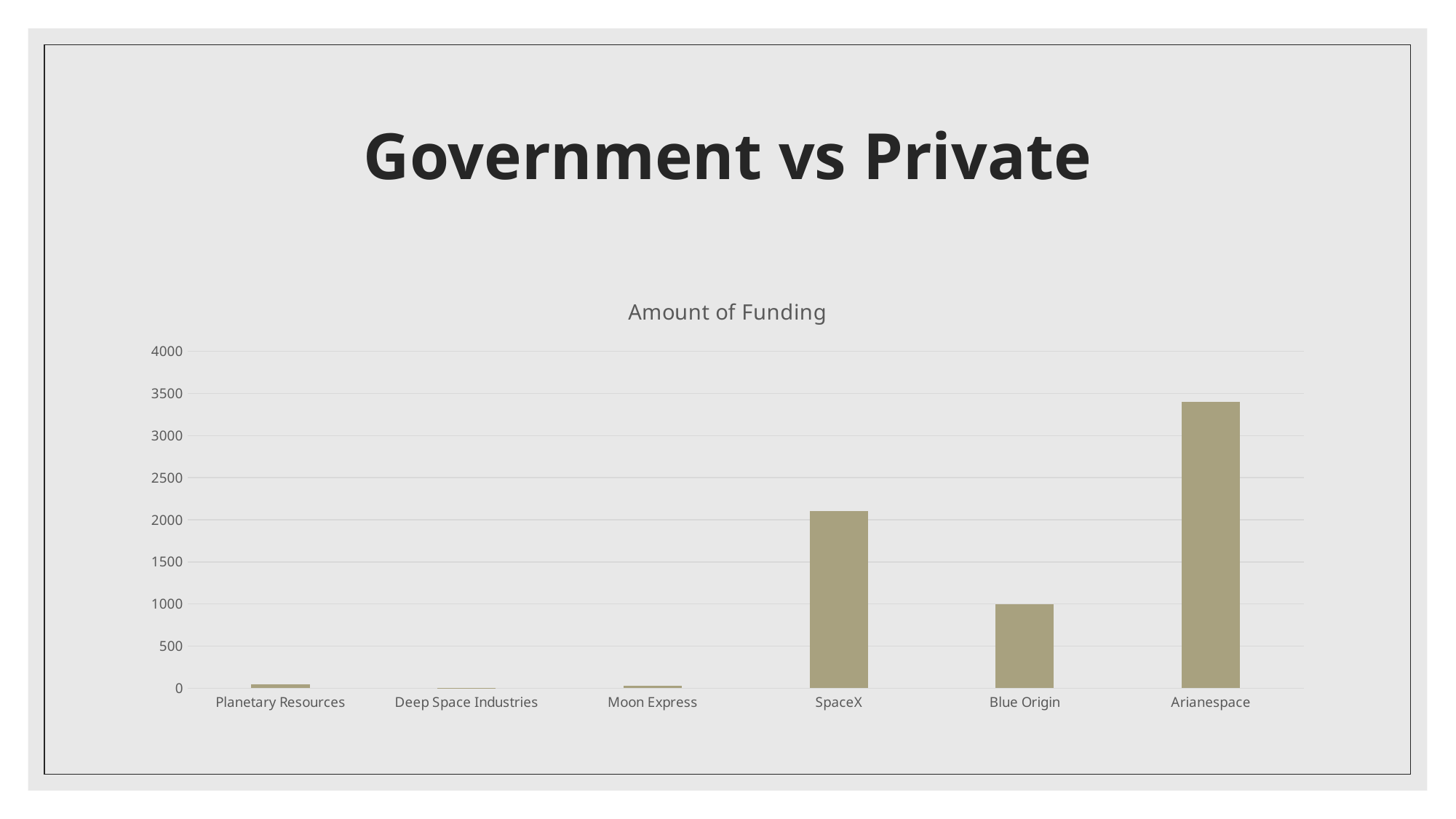
Which has a larger amount of funding, SpaceX or Blue Origin? SpaceX Which category has the lowest amount of funding? Deep Space Industries Is the value for SpaceX greater or less than 2000? greater Which category has the highest amount of funding? Arianespace How many categories are shown on the x axis of the chart? 6 Is the value for Arianespace greater or less than 3000? greater Is the value for SpaceX greater or less than 2500? less What is the title of the chart? Amount of Funding Which has a larger amount of funding, Arianespace or SpaceX? Arianespace What kind of chart is shown on the slide? bar chart